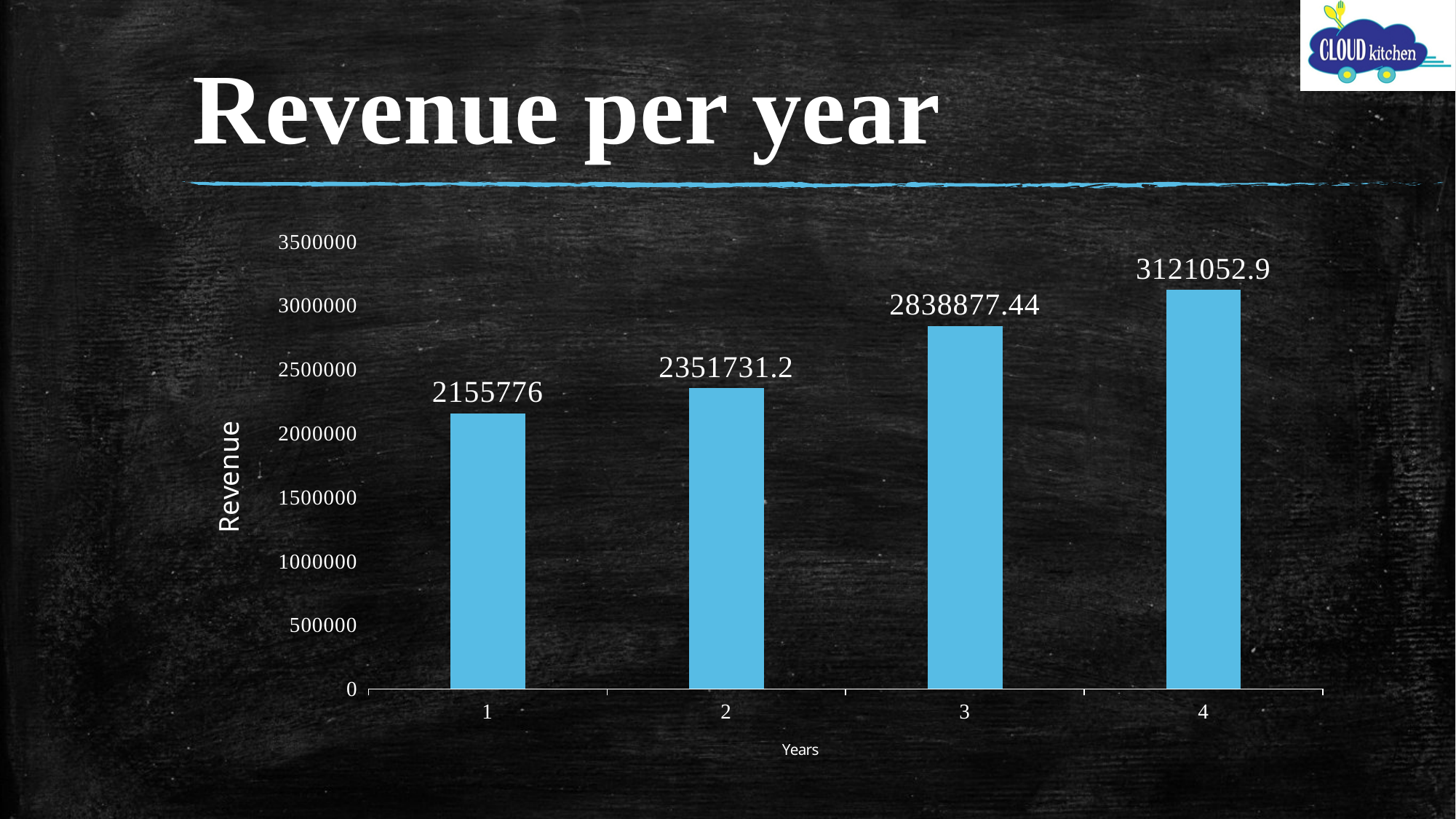
What kind of chart is shown on the slide? bar chart Which year has higher revenue, year 2 or year 3? 3 Is the revenue for year 4 greater or less than 3000000? greater Which year has the highest revenue? 4 What is the revenue for year 3? 2838877.44 Does revenue rise or fall from year 1 to year 4? rise Which year has the lowest revenue? 1 What is the revenue for year 4? 3121052.9 What is the difference in revenue between year 4 and year 1? 965276.9 What is the revenue for year 1? 2155776 How many years are shown on the chart? 4 What is the difference in revenue between year 3 and year 2? 487146.24